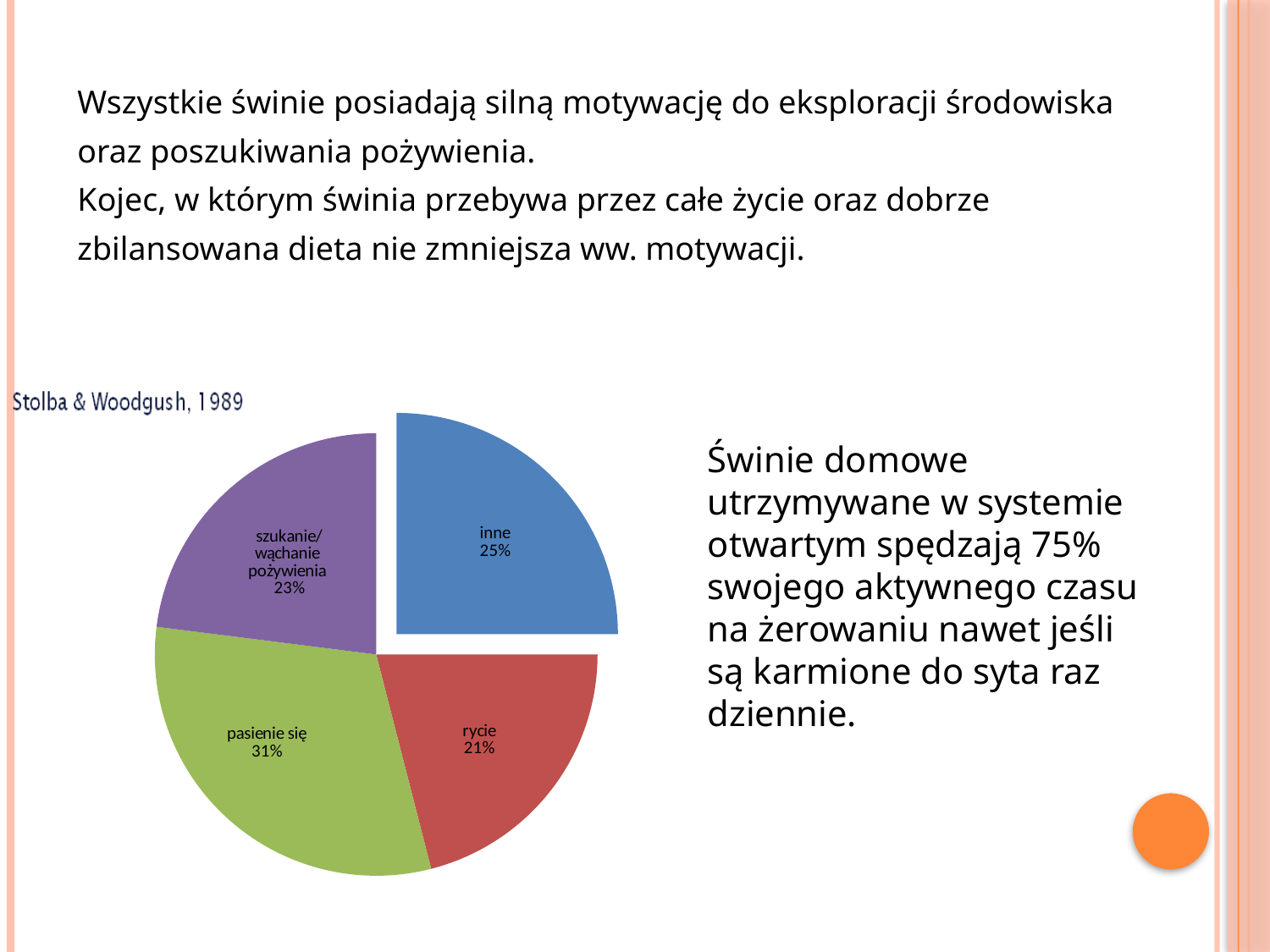
Which slice of the pie chart is the smallest? rycie What share of the pie does "pasienie się" represent? 31% What share of the pie does "szukanie/wąchanie pożywienia" represent? 23% Which slice of the pie chart is the largest? pasienie się What share of the pie does "inne" represent? 25% Which is larger, the share for "inne" or the share for "szukanie/wąchanie pożywienia"? inne What is the combined share of "pasienie się", "rycie" and "szukanie/wąchanie pożywienia"? 75% What colour is the "inne" slice of the pie chart? blue How many slices does the pie chart have? 4 What kind of chart is shown on the slide? pie chart What is the difference in percentage points between "pasienie się" and "rycie"? 10